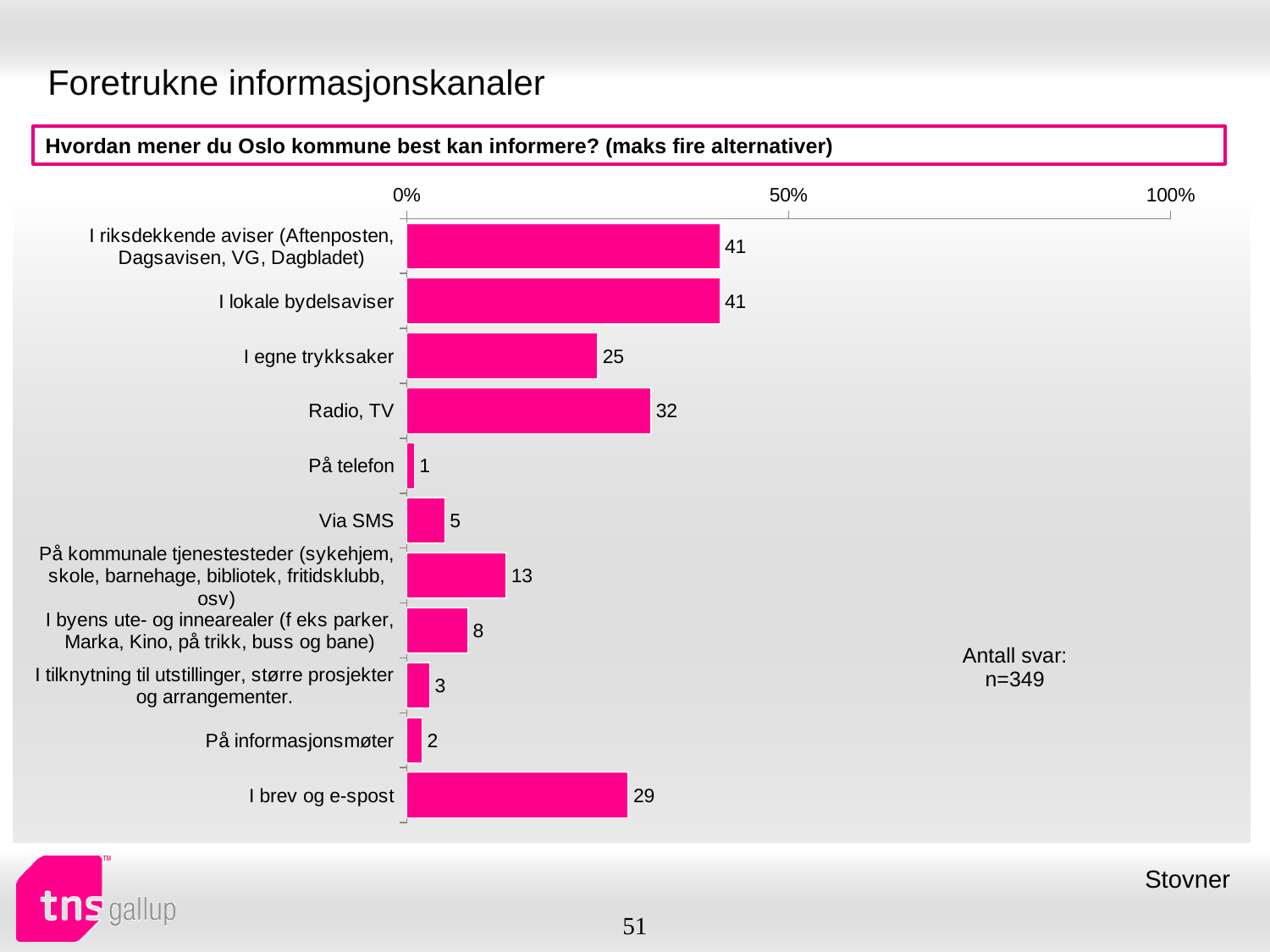
Which category has the lowest value? På telefon What is the value for "I brev og e-spost"? 29 How many categories are shown in the chart? 11 What is the difference between the values for "Radio, TV" and "I egne trykksaker"? 7 What is the value for "I egne trykksaker"? 25 What is the value for "Via SMS"? 5 Is the value for "I lokale bydelsaviser" greater or less than 50%? less What kind of chart is shown on the slide? bar chart What is the number of responses (Antall svar) shown on the slide? n=349 What is the difference between the values for "På kommunale tjenestesteder (sykehjem, skole, barnehage, bibliotek, fritidsklubb, osv)" and "I byens ute- og innearealer (f eks parker, Marka, Kino, på trikk, buss og bane)"? 5 Which is larger, the value for "I brev og e-spost" or the value for "Radio, TV"? Radio, TV What is the value for "Radio, TV"? 32